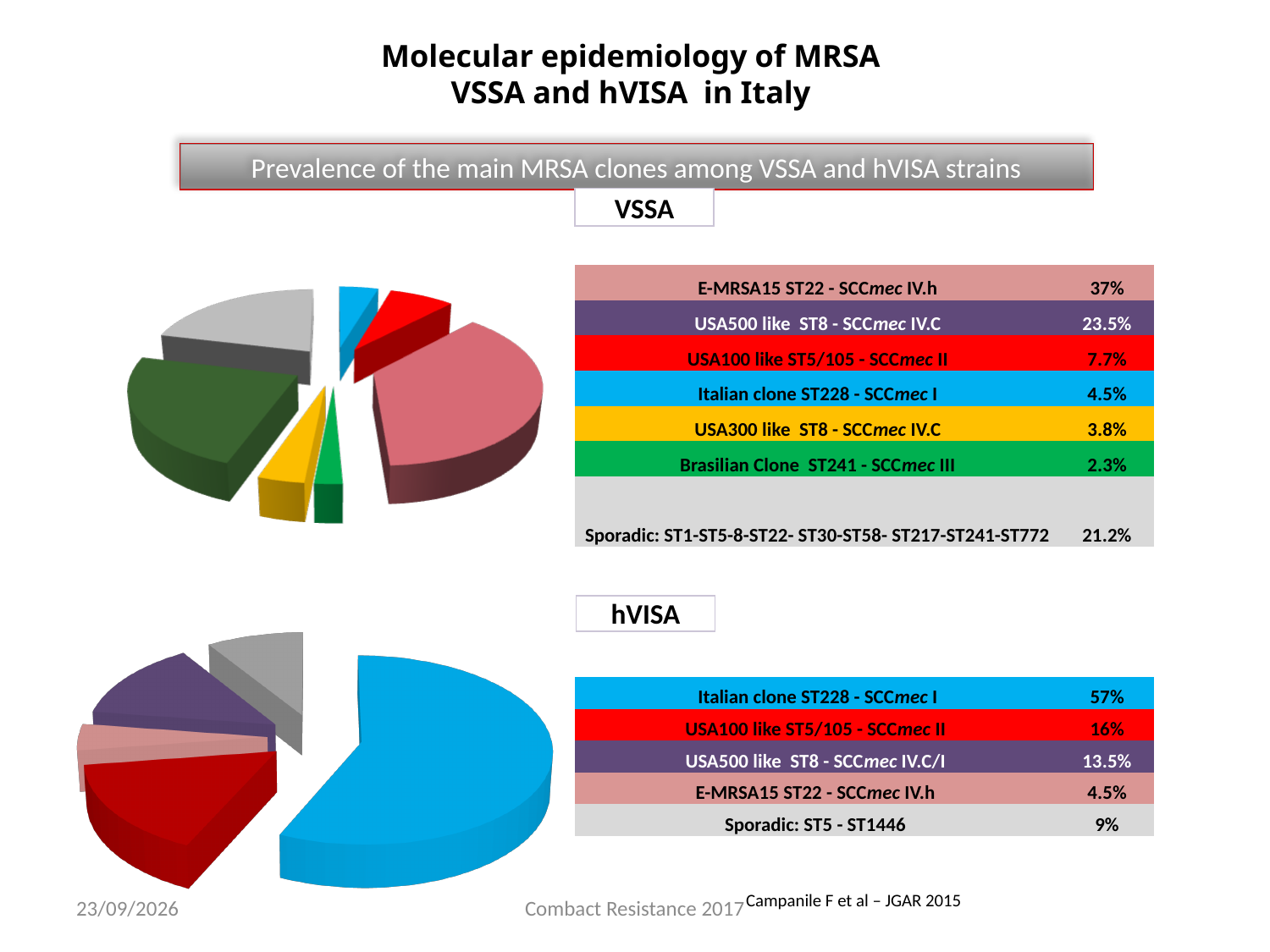
In the VSSA chart, which clone has the largest share? E-MRSA15 ST22 - SCCmec IV.h How many categories are listed for the VSSA chart? 7 What kind of chart is used for the VSSA data? pie chart In the hVISA chart, what is the share for Italian clone ST228 - SCCmec I? 57% In the VSSA chart, what is the share for E-MRSA15 ST22 - SCCmec IV.h? 37% In the VSSA chart, what is the share for USA500 like ST8 - SCCmec IV.C? 23.5% In the hVISA chart, which is larger: USA100 like ST5/105 - SCCmec II or USA500 like ST8 - SCCmec IV.C/I? USA100 like ST5/105 - SCCmec II In the VSSA chart, which clone has the smallest share? Brasilian Clone ST241 - SCCmec III In the hVISA chart, what is the difference between the shares of Italian clone ST228 - SCCmec I and USA100 like ST5/105 - SCCmec II? 41% How many categories are listed for the hVISA chart? 5 In the VSSA chart, what is the difference between the shares of USA100 like ST5/105 - SCCmec II and Italian clone ST228 - SCCmec I? 3.2% In the hVISA chart, what is the share for Sporadic: ST5 - ST1446? 9%